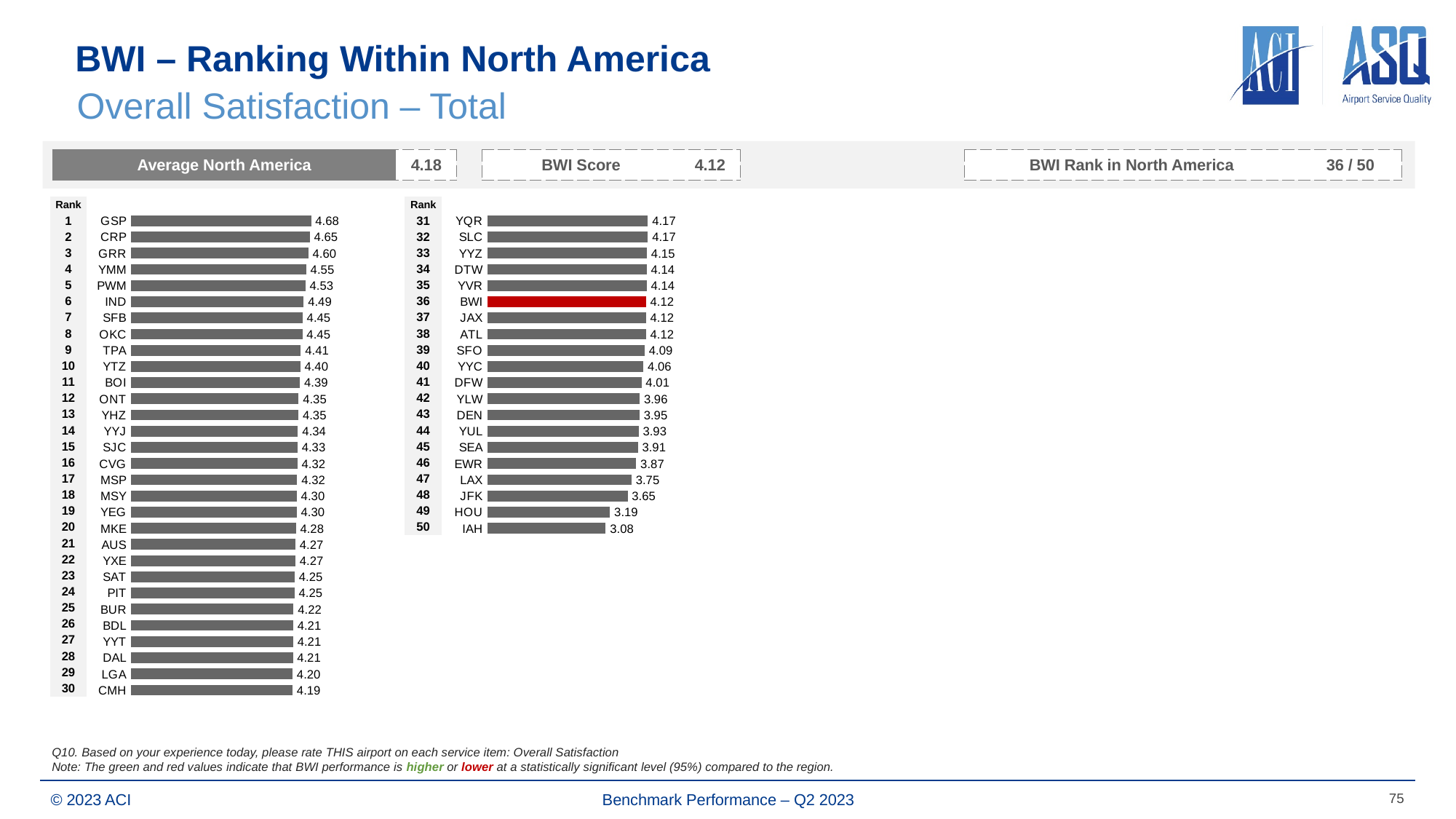
How many airports are plotted in the right chart (ranks 31–50)? 20 In the right chart (ranks 31–50), which airport has the lowest value? IAH In the left chart (ranks 1–30), what is the difference between the values for GSP and CMH? 0.49 In the left chart (ranks 1–30), which airport has the highest value? GSP In the right chart (ranks 31–50), what is the difference between the values for YQR and IAH? 1.09 In the left chart (ranks 1–30), which airport has the lowest value? CMH In the right chart (ranks 31–50), what is the value for BWI? 4.12 In the right chart (ranks 31–50), which airport's bar is coloured red? BWI What kind of chart is used to show the airport scores on this slide? Bar chart In the right chart (ranks 31–50), which is larger, the value for LAX or the value for JFK? LAX In the right chart (ranks 31–50), what is the value for IAH? 3.08 In the left chart (ranks 1–30), what is the value for GSP? 4.68